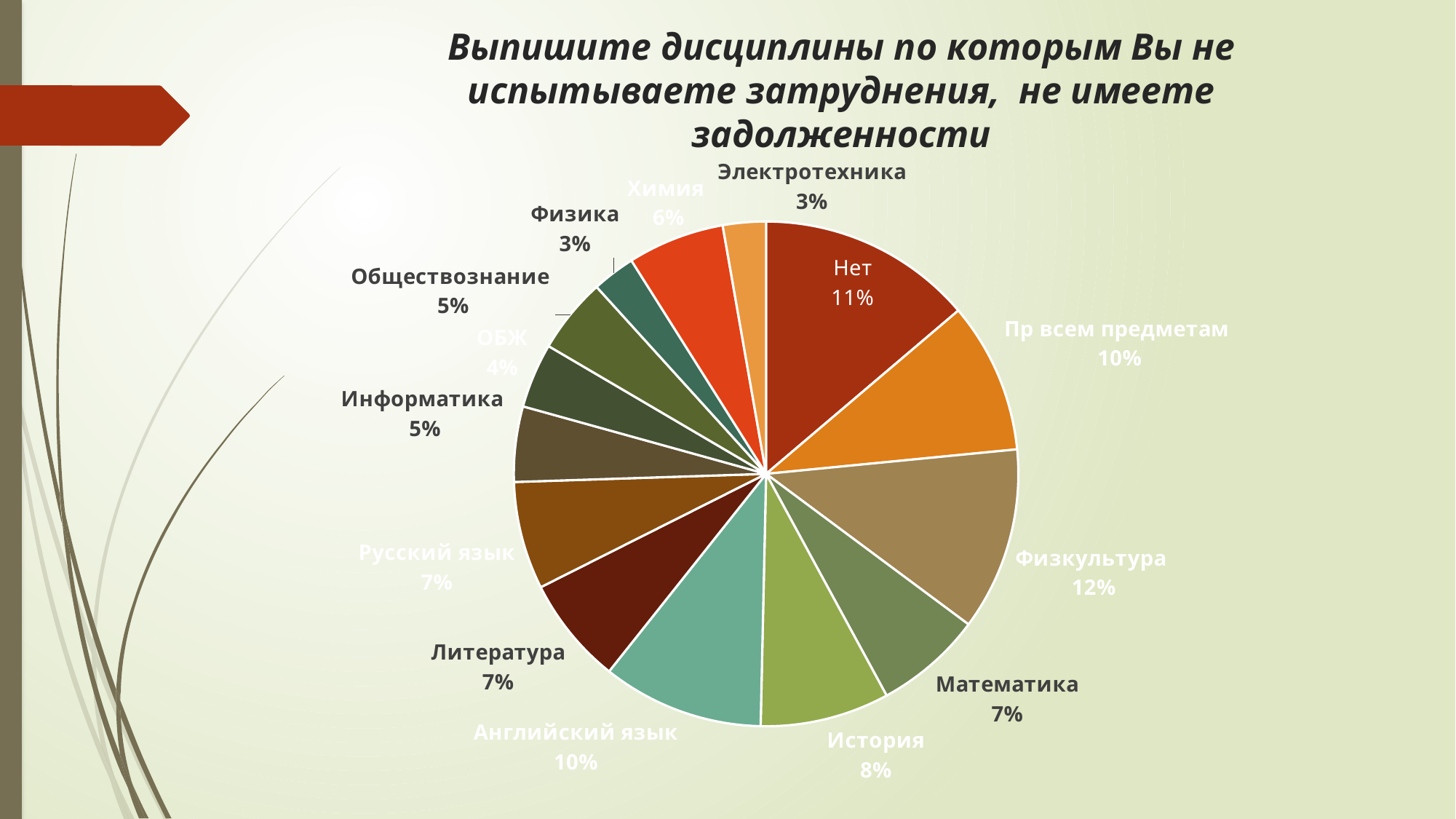
What percentage is shown for ОБЖ? 4% What percentage is shown for История? 8% What percentage is shown for Английский язык? 10% What kind of chart is shown on the slide? pie chart What share of the pie does Физкультура have? 12% Which is larger, the slice for История or the slice for Математика? История What is the combined share of Литература and Русский язык? 14% What percentage is shown for Химия? 6% What is the difference in percentage points between Нет and Физика? 8 How many slices does the pie chart have? 14 Which is larger, the slice for Нет or the slice for Пр всем предметам? Нет